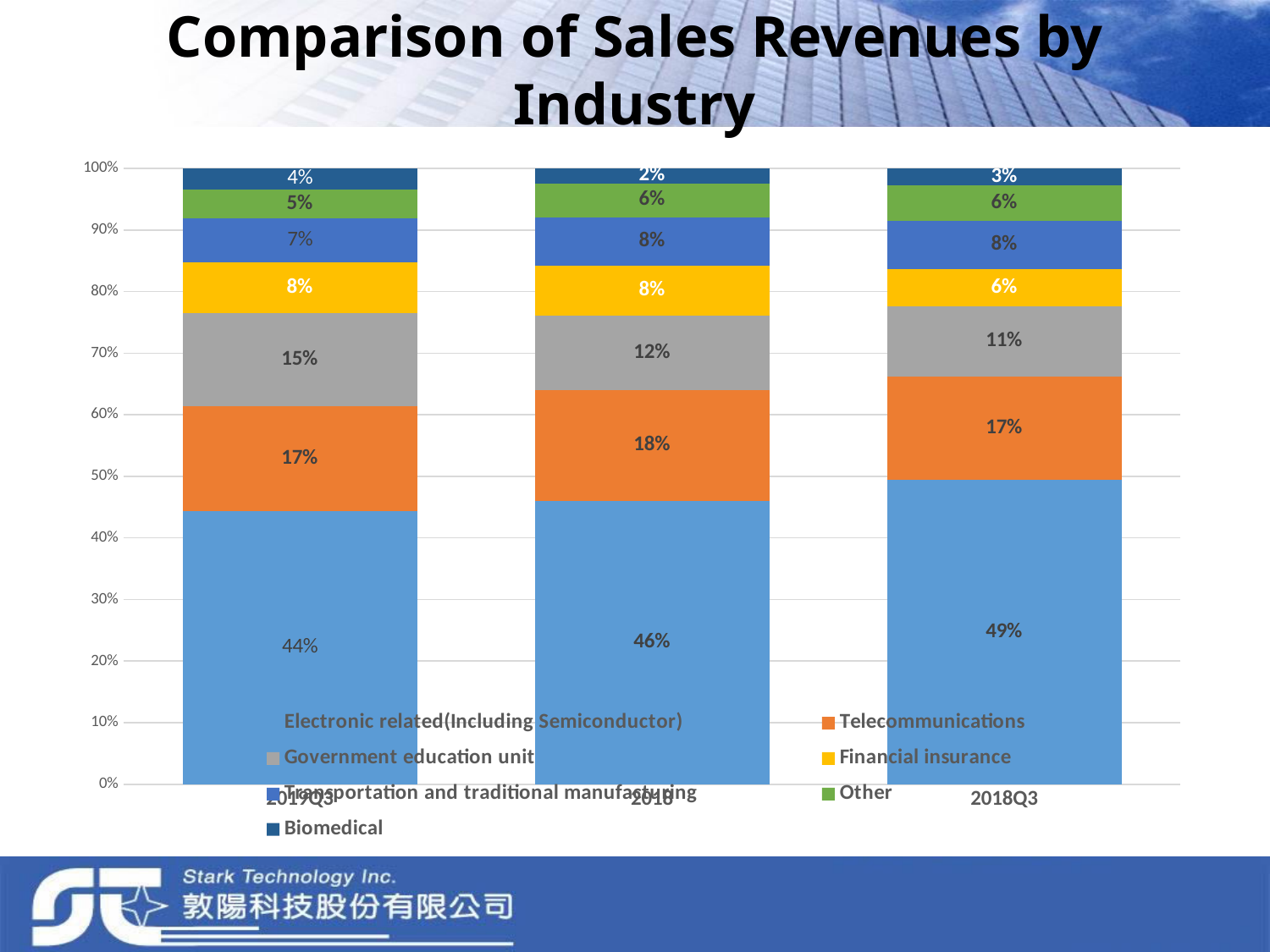
How many bars (periods) are plotted on the chart? 3 What is the share of Electronic related(Including Semiconductor) in 2019Q3? 44% What is the share of Government education unit in 2019Q3? 15% Which is larger in 2019Q3: the Financial insurance share or the Transportation and traditional manufacturing share? Financial insurance What is the share of Electronic related(Including Semiconductor) in 2018Q3? 49% Which period has the lowest share for Biomedical? the middle bar (2018) What is the share of Biomedical in 2018Q3? 3% How many series does the legend list? 7 What is the difference between the Government education unit share in 2019Q3 and in 2018Q3? 4% What type of chart is shown on the slide? stacked bar chart What is the share of Telecommunications in the middle bar? 18% Which period has the highest share for Electronic related(Including Semiconductor)? 2018Q3